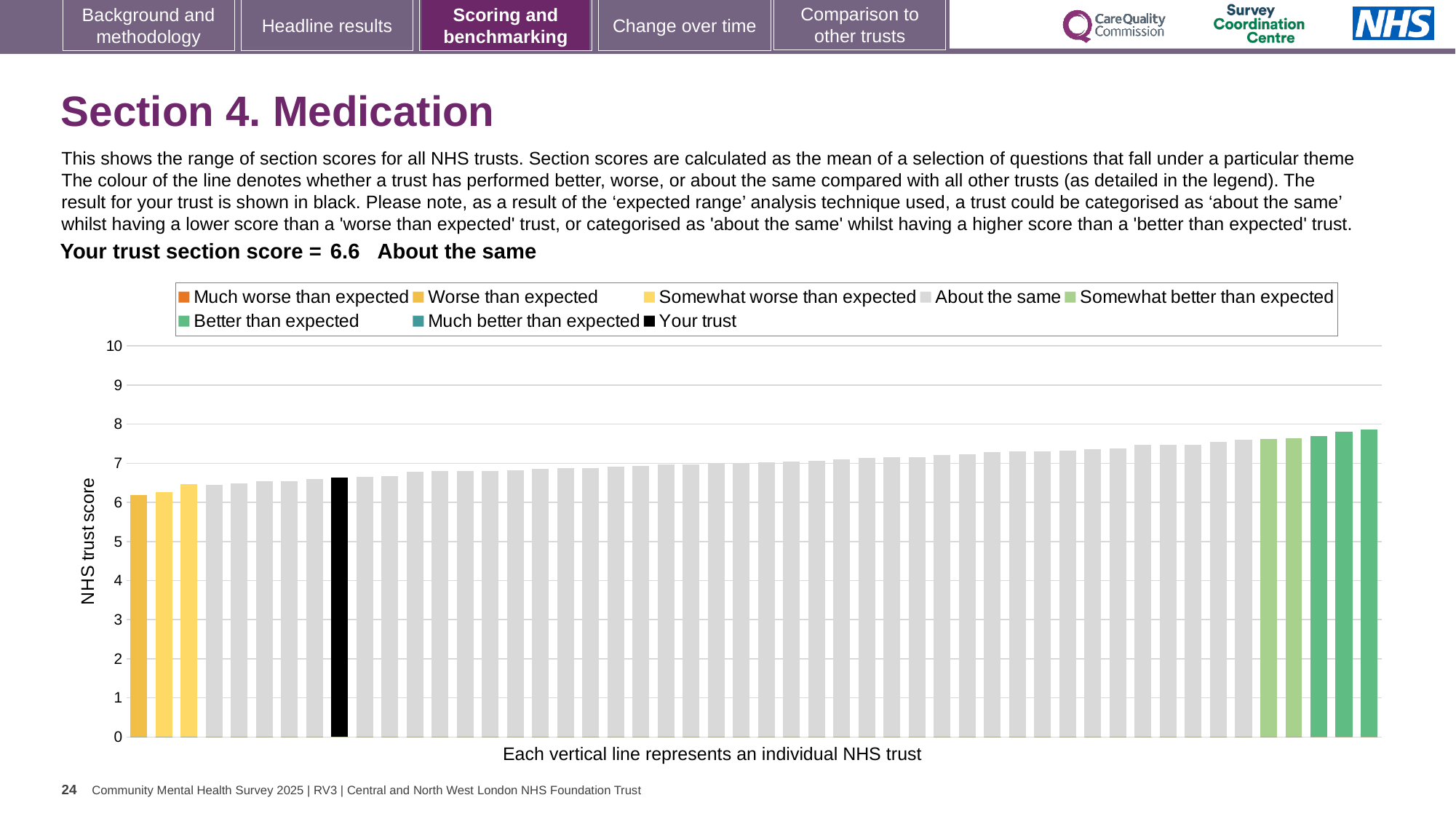
What is the section score for your trust shown on the slide? 6.6 Is the value of the tallest bar in the chart greater or less than 8? less Is the value of the black bar (your trust) greater or less than 7? less Which category is your trust's section score placed in? About the same Is the value of the black bar (your trust) greater or less than 6? greater What kind of chart is shown on the slide? bar chart What is the label on the vertical axis of the chart? NHS trust score How many bars in the chart are coloured black? 1 How many entries does the chart legend list? 8 Do the bar values rise or fall from left to right across the chart? rise